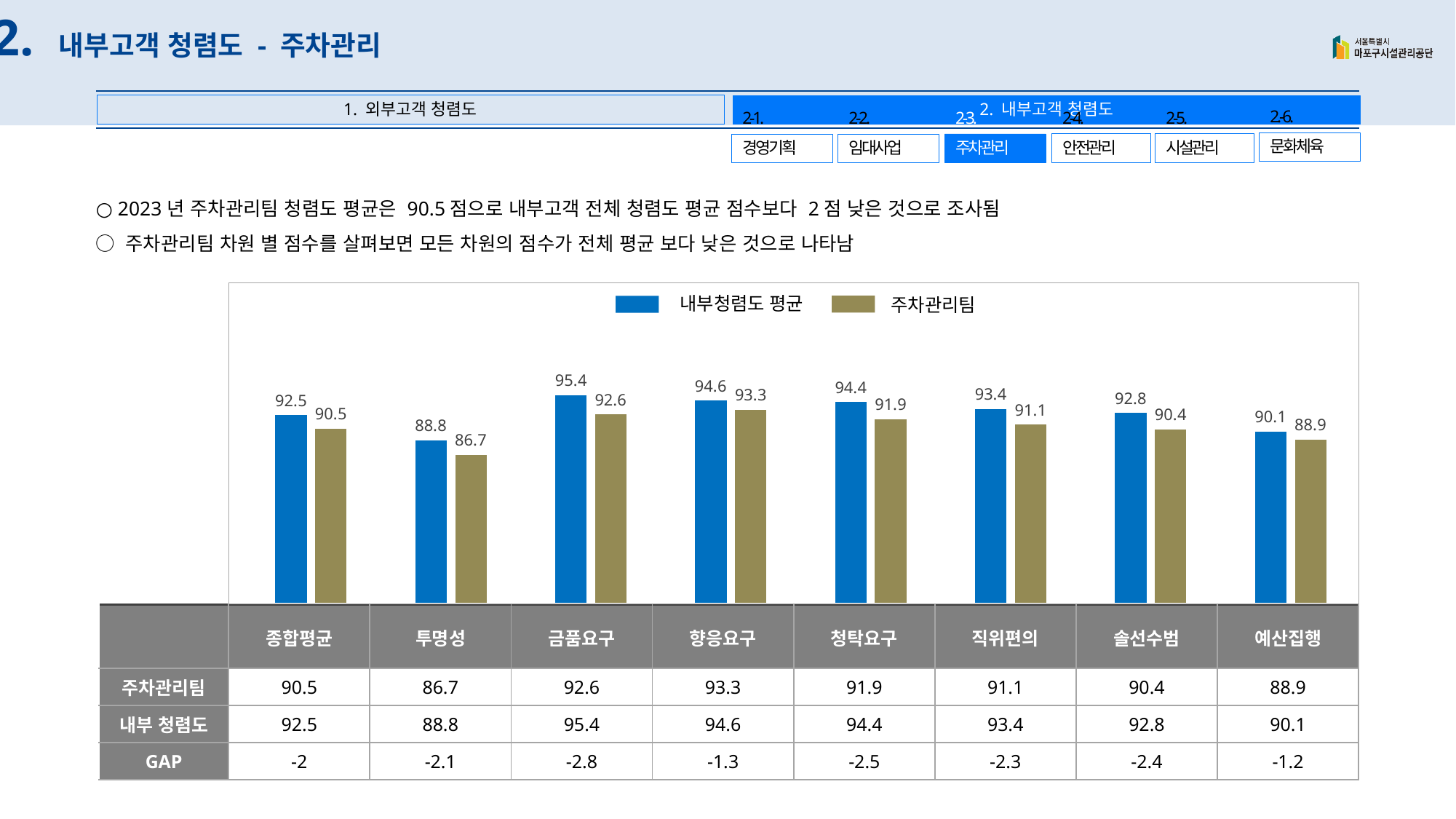
What is the value of 주차관리팀 for 예산집행? 88.9 What is the difference between 내부청렴도 평균 and 주차관리팀 for 청탁요구? 2.5 How many series does the chart legend list? 2 Which is larger for 향응요구: 내부청렴도 평균 or 주차관리팀? 내부청렴도 평균 What is the value of 주차관리팀 for 종합평균? 90.5 Which category has the lowest 주차관리팀 value? 투명성 What is the value of 내부청렴도 평균 for 금품요구? 95.4 How many categories are plotted along the x axis of the chart? 8 What type of chart is shown on the slide? bar chart Which series is shown in blue in the chart? 내부청렴도 평균 Which category has the highest 내부청렴도 평균 value? 금품요구 What is the value of 주차관리팀 for 투명성? 86.7